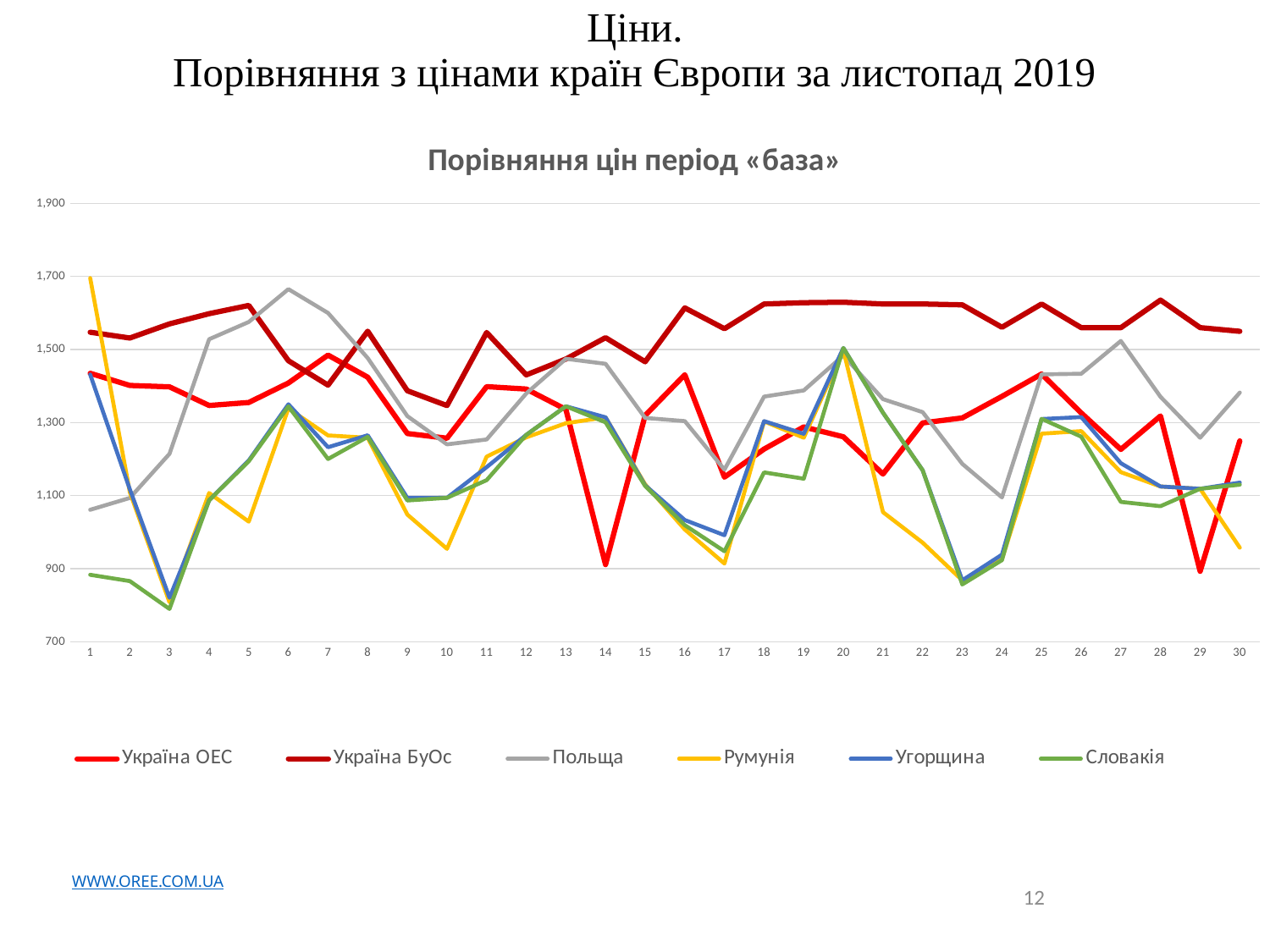
Which series has the lowest value at point 10? Румунія What kind of chart is shown on the slide? line chart Is the value for Україна ОЕС at point 14 greater or less than 1,100? less Is the value for Польща at point 6 greater or less than 1,500? greater What is the title of the chart? Порівняння цін період «база» Which series has the highest value at point 20? Україна БуОс At point 3, which is larger: Україна БуОс or Словакія? Україна БуОс Is the value for Румунія at point 1 greater or less than 1,500? greater Which colour is used for the Румунія series in the legend? yellow How many points are there along the x axis? 30 How many series does the legend list? 6